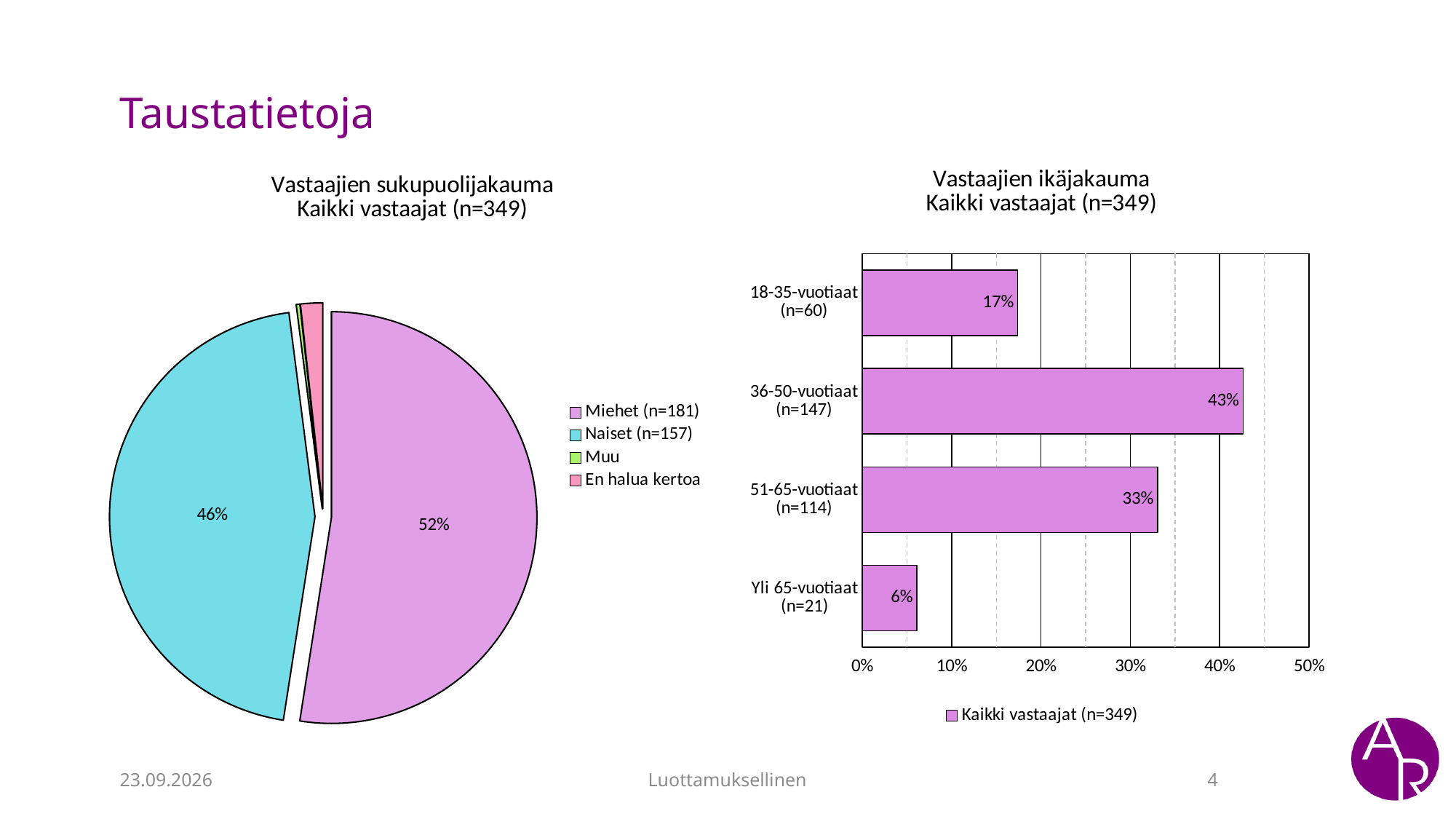
In the 'Vastaajien sukupuolijakauma' pie chart, what share is shown for Miehet (n=181)? 52% In the 'Vastaajien ikäjakauma' chart, how many age groups are shown? 4 In the 'Vastaajien sukupuolijakauma' pie chart, how many categories does the legend list? 4 In the 'Vastaajien sukupuolijakauma' pie chart, which category has the largest slice? Miehet (n=181) In the 'Vastaajien ikäjakauma' chart, what is the difference between the values for 36-50-vuotiaat and 51-65-vuotiaat? 10% In the 'Vastaajien sukupuolijakauma' pie chart, what share is shown for Naiset (n=157)? 46% In the 'Vastaajien ikäjakauma' chart, what is the value for 36-50-vuotiaat (n=147)? 43% In the 'Vastaajien ikäjakauma' chart, what is the value for Yli 65-vuotiaat (n=21)? 6% In the 'Vastaajien ikäjakauma' chart, which is larger: the value for 18-35-vuotiaat or for 51-65-vuotiaat? 51-65-vuotiaat What kind of chart is the 'Vastaajien sukupuolijakauma' chart? Pie chart What kind of chart is the 'Vastaajien ikäjakauma' chart? Bar chart In the 'Vastaajien ikäjakauma' chart, which age group has the lowest value? Yli 65-vuotiaat (n=21)